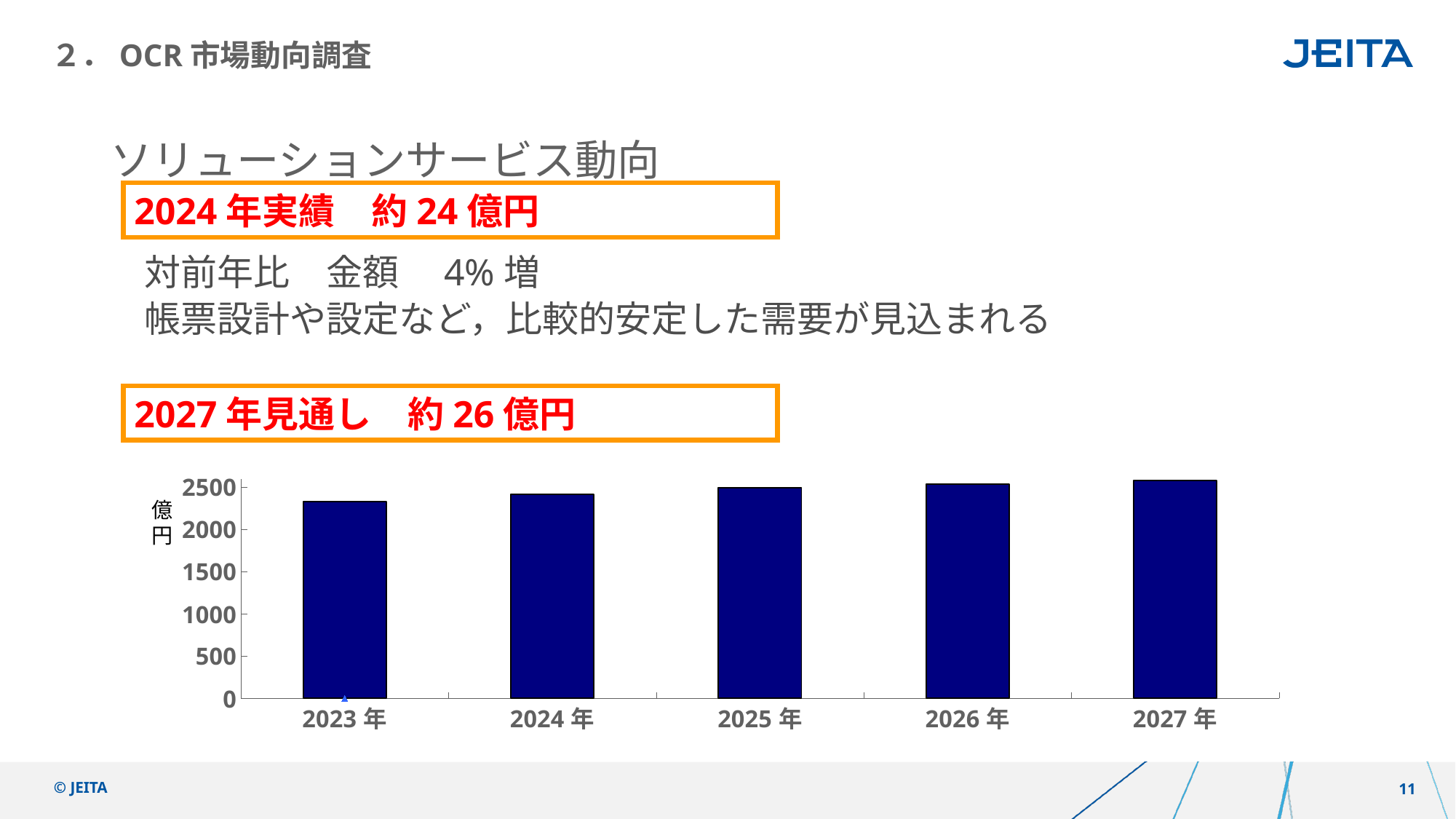
How many years are shown on the x axis of the chart? 5 Is the value for 2027年 greater or less than 2500? greater What is the highest tick value shown on the y axis of the chart? 2500 Which is larger, the bar for 2023年 or the bar for 2027年? 2027年 What kind of chart is shown on the slide? bar chart Which year has the highest bar in the chart? 2027年 Is the value for 2023年 greater or less than 2000? greater Is the value for 2024年 greater or less than 2500? less Which year has the lowest bar in the chart? 2023年 Do the bar values rise or fall from 2023年 to 2027年? rise What unit label is shown on the y axis of the chart? 億円